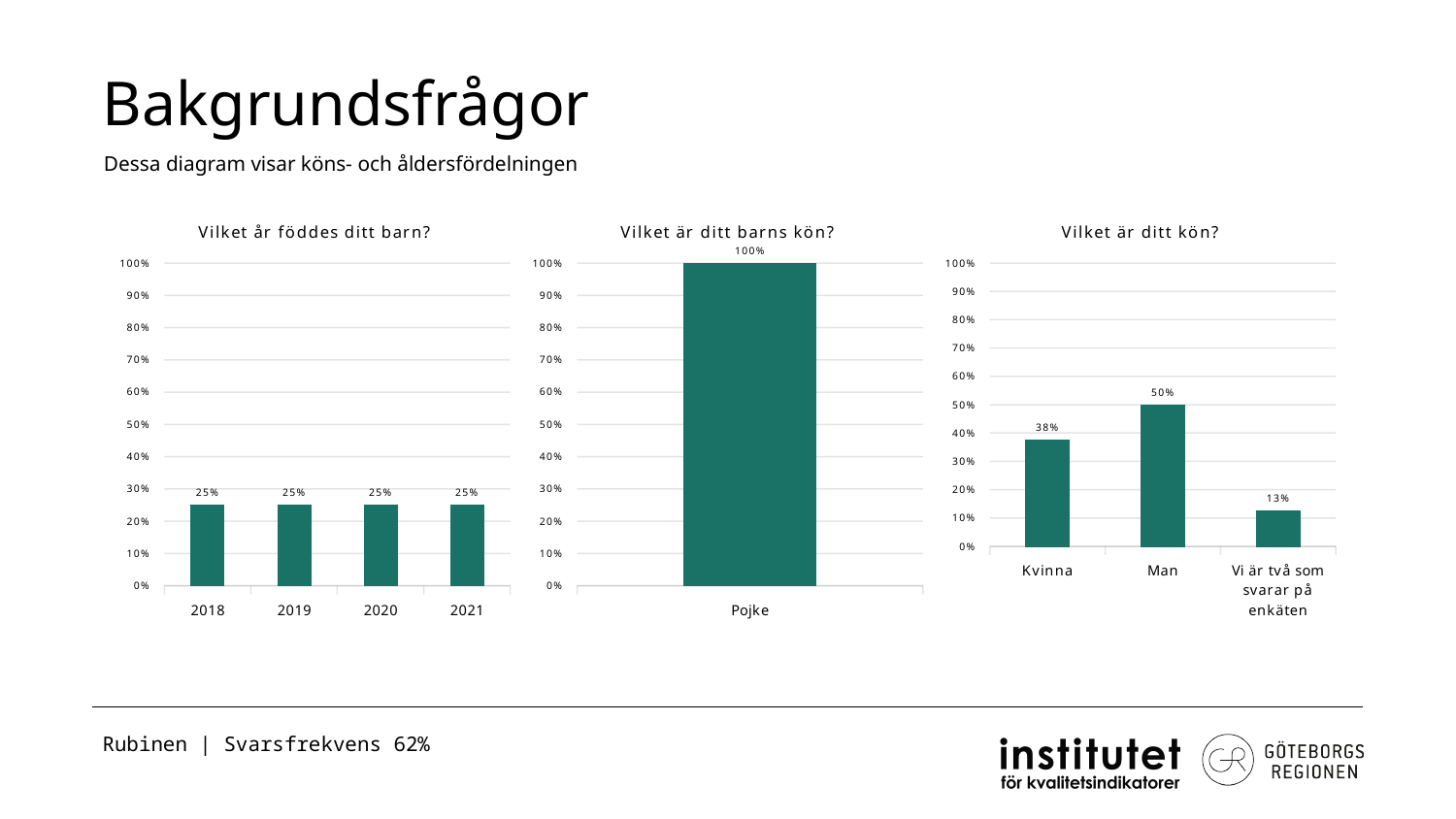
In the chart 'Vilket är ditt kön?', what is the value for Man? 50% What kind of chart is 'Vilket är ditt kön?'? bar chart In the chart 'Vilket år föddes ditt barn?', what is the value for 2019? 25% In the chart 'Vilket är ditt barns kön?', how many categories are shown? 1 In the chart 'Vilket är ditt kön?', what is the value for Kvinna? 38% In the chart 'Vilket är ditt kön?', which category has the highest value? Man In the chart 'Vilket är ditt barns kön?', what is the value for Pojke? 100% In the chart 'Vilket år föddes ditt barn?', what is the difference between the values for 2018 and 2021? 0% In the chart 'Vilket är ditt kön?', which category has the lowest value? Vi är två som svarar på enkäten In the chart 'Vilket år föddes ditt barn?', how many categories are shown on the x axis? 4 In the chart 'Vilket är ditt kön?', is the value for Kvinna greater or less than 40%? less In the chart 'Vilket är ditt kön?', what is the difference between the values for Man and Kvinna? 12%